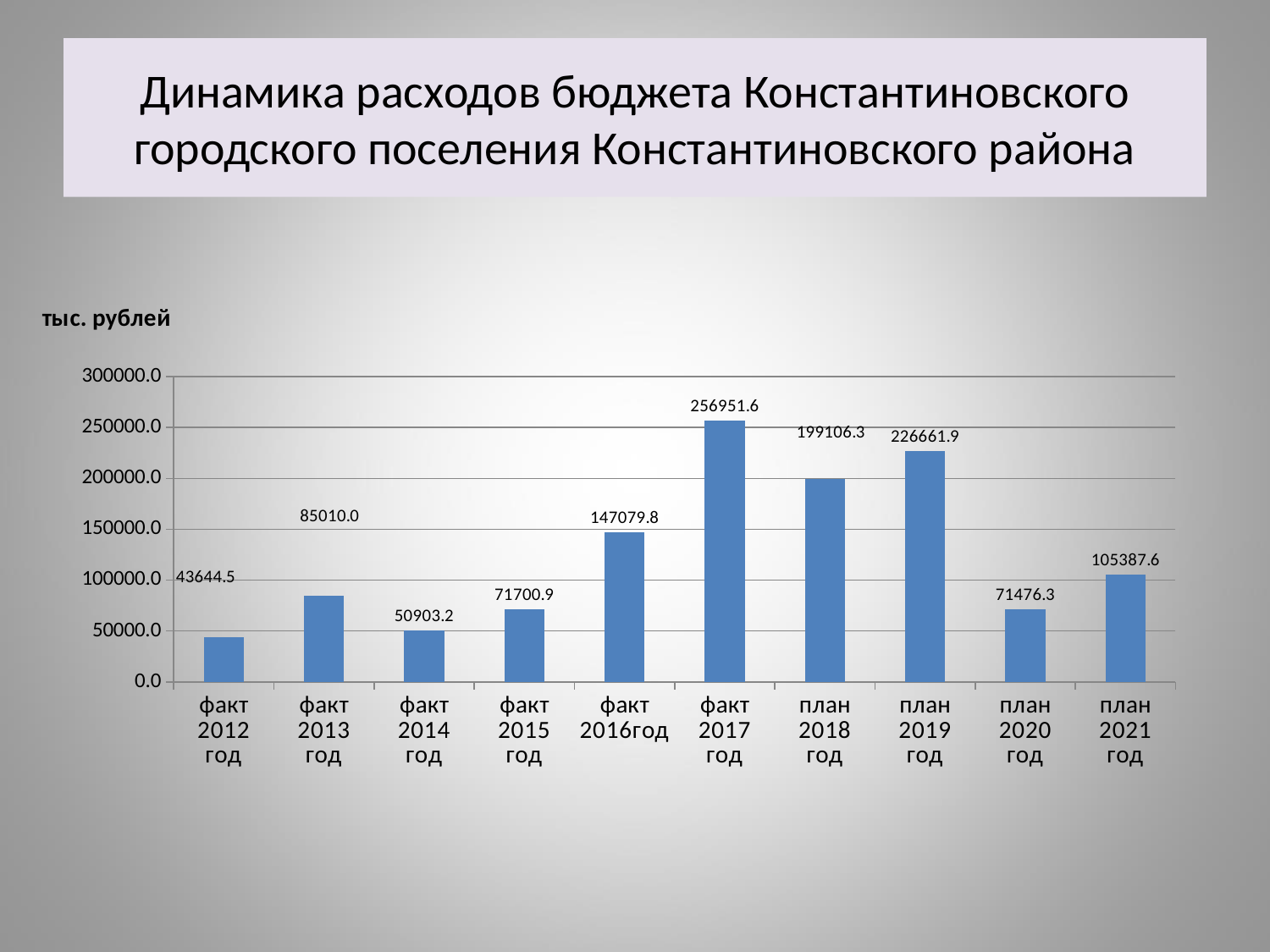
What is the difference between the values for факт 2017 год and факт 2012 год? 213307.1 What is the difference between the values for план 2019 год and план 2018 год? 27555.6 What unit is indicated above the chart? тыс. рублей Is the value for план 2018 год greater or less than 150000.0? greater What kind of chart is shown on the slide? bar chart Which category has the lowest value? факт 2012 год How many categories are shown on the x axis? 10 Which is larger, the value for факт 2013 год or факт 2014 год? факт 2013 год What is the value for факт 2014 год? 50903.2 What is the value for план 2020 год? 71476.3 What is the value for факт 2017 год? 256951.6 Which category has the highest value? факт 2017 год